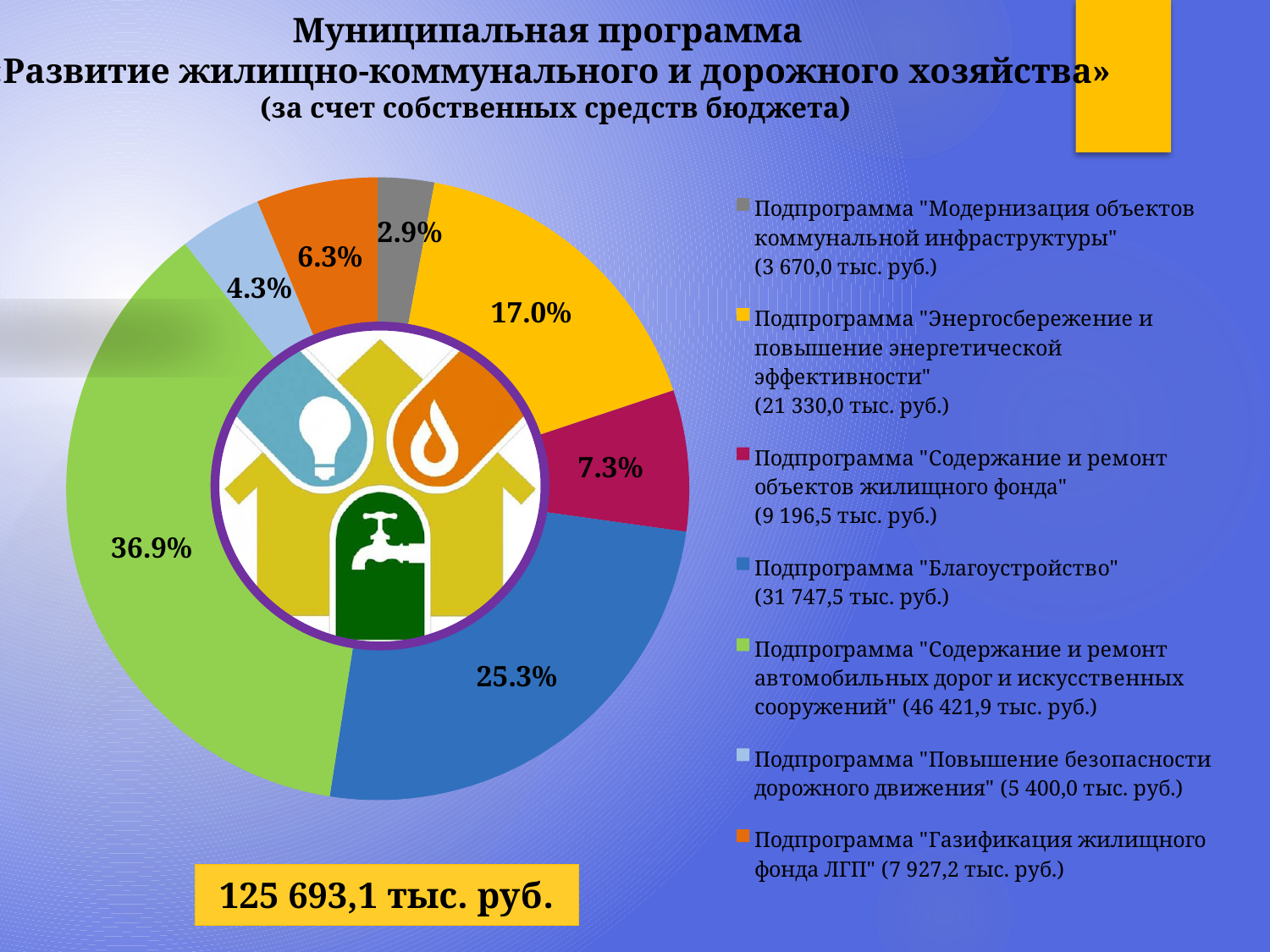
How many entries does the legend list? 7 What share of the pie does the subprogram "Модернизация объектов коммунальной инфраструктуры" take? 2.9% Which subprogram has the smallest slice of the pie? Модернизация объектов коммунальной инфраструктуры What amount in тыс. руб. does the legend give for the subprogram "Благоустройство"? 31 747,5 тыс. руб. Which subprogram has the largest slice of the pie? Содержание и ремонт автомобильных дорог и искусственных сооружений Which slice is larger: "Газификация жилищного фонда ЛГП" or "Повышение безопасности дорожного движения"? Газификация жилищного фонда ЛГП How many slices does the pie chart have? 7 What share of the pie does the subprogram "Благоустройство" take? 25.3% What is the difference in percentage points between the slices for "Благоустройство" and "Содержание и ремонт объектов жилищного фонда"? 18.0 What kind of chart is shown on the slide? doughnut chart What share of the pie does the subprogram "Энергосбережение и повышение энергетической эффективности" take? 17.0%